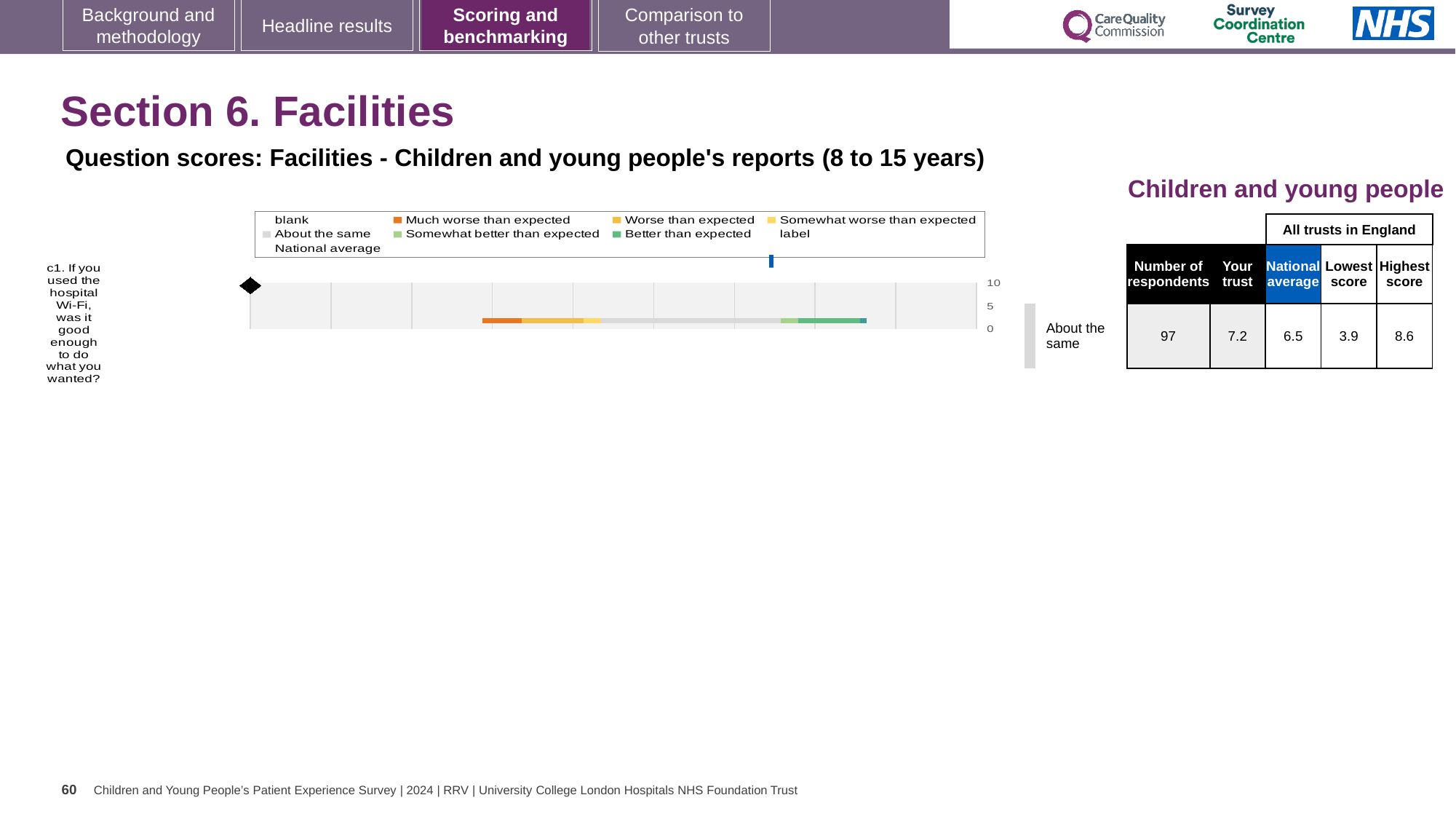
For question c1, what is the difference between the highest score and the lowest score across all trusts in England? 4.7 For question c1, how much higher is the 'Your trust' score than the national average? 0.7 How many questions are plotted in the chart on this slide? 1 What benchmark category is given for question c1 next to the chart? About the same What is the national average score for question c1 in the table beside the chart? 6.5 For question c1, which is larger: the 'Your trust' score or the national average? Your trust What is the 'Your trust' score for question c1 in the table beside the chart? 7.2 What is the lowest score across all trusts in England for question c1? 3.9 Which question is plotted in the chart on this slide? c1. If you used the hospital Wi-Fi, was it good enough to do what you wanted? How many respondents answered question c1 according to the table beside the chart? 97 What kind of chart is used to show the question score for c1 on this slide? bar chart What is the highest score across all trusts in England for question c1? 8.6